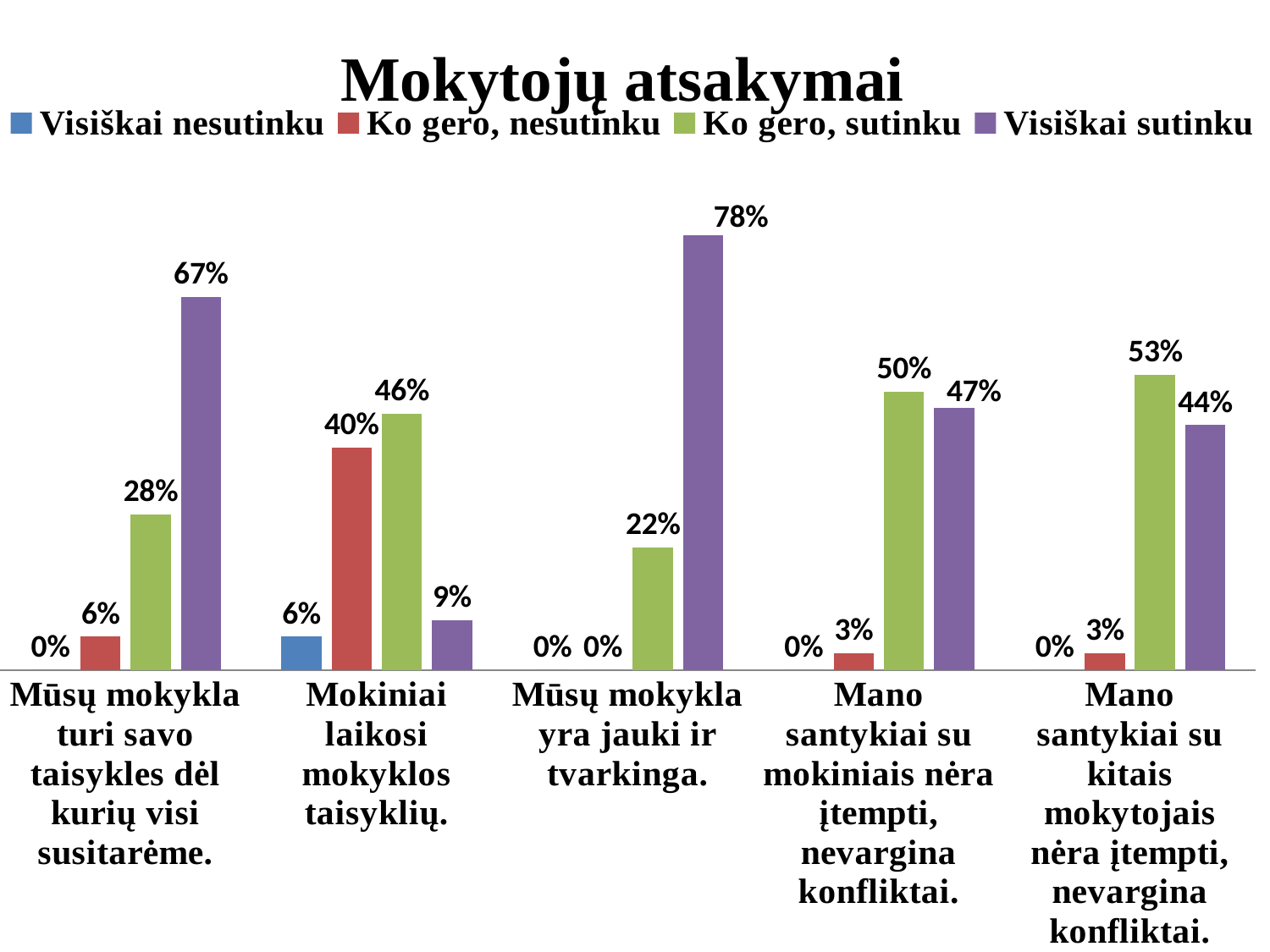
How many series does the legend list? 4 What kind of chart is shown on the slide? Bar chart How many categories are shown on the x axis? 5 What is the value of "Ko gero, sutinku" for "Mano santykiai su kitais mokytojais nėra įtempti, nevargina konfliktai."? 53% Which category has the highest "Visiškai sutinku" value? Mūsų mokykla yra jauki ir tvarkinga. What is the title of the chart? Mokytojų atsakymai For "Mano santykiai su mokiniais nėra įtempti, nevargina konfliktai.", which is larger: "Ko gero, sutinku" or "Visiškai sutinku"? Ko gero, sutinku What is the value of "Visiškai sutinku" for "Mūsų mokykla yra jauki ir tvarkinga."? 78% Which category has the lowest "Visiškai sutinku" value? Mokiniai laikosi mokyklos taisyklių. What is the value of "Visiškai nesutinku" for "Mokiniai laikosi mokyklos taisyklių."? 6% What is the value of "Ko gero, nesutinku" for "Mokiniai laikosi mokyklos taisyklių."? 40% What is the difference between the "Visiškai sutinku" and "Ko gero, sutinku" values for "Mūsų mokykla turi savo taisykles dėl kurių visi susitarėme."? 39%